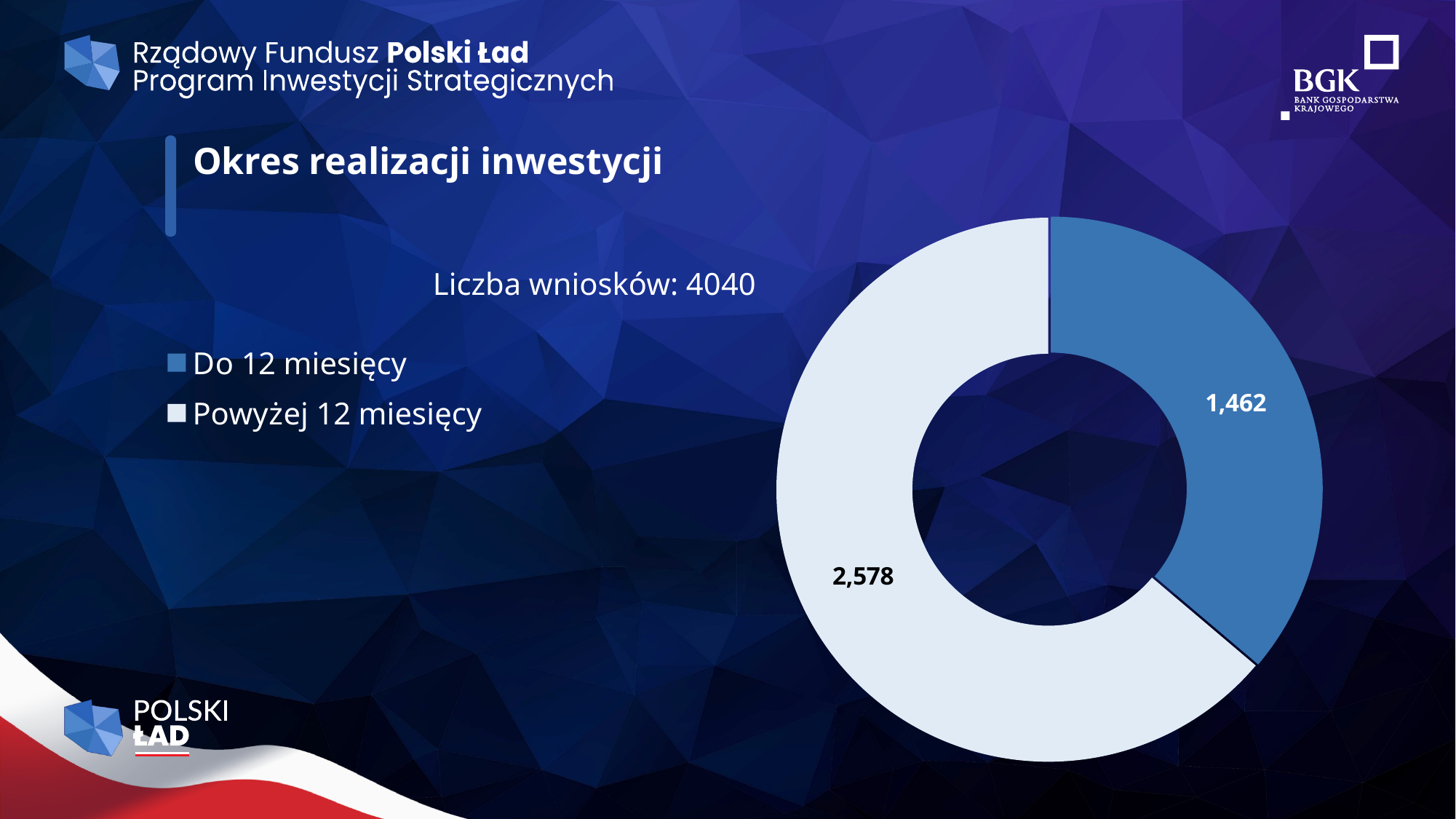
Which category has the largest slice? Powyżej 12 miesięcy How many categories does the chart show? 2 What is the value for "Do 12 miesięcy"? 1,462 Which is larger: "Do 12 miesięcy" or "Powyżej 12 miesięcy"? Powyżej 12 miesięcy What is the value for "Powyżej 12 miesięcy"? 2,578 What share of the total does "Do 12 miesięcy" represent? 36.2% What is the total of the two slices in the chart? 4,040 What colour is the slice for "Do 12 miesięcy"? Blue What is the title of the chart? Okres realizacji inwestycji What is the difference between the values for "Powyżej 12 miesięcy" and "Do 12 miesięcy"? 1,116 What kind of chart is shown on the slide? Doughnut (pie) chart Which category has the smallest slice? Do 12 miesięcy